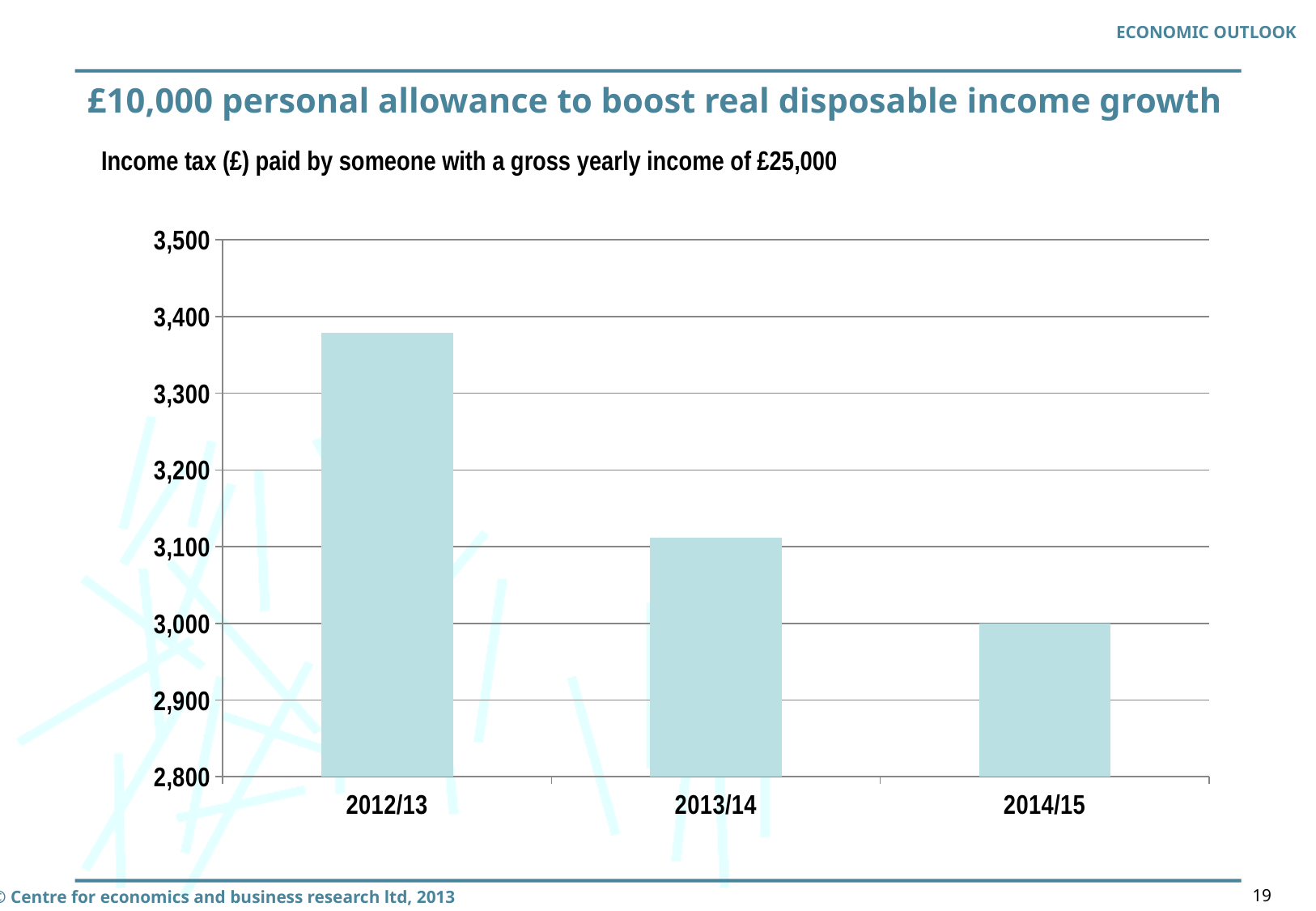
Is the income tax paid in 2013/14 greater or less than 3,100? greater Which tax year has the highest income tax paid in the chart? 2012/13 Which tax year has the lowest income tax paid in the chart? 2014/15 What is the title of the chart? Income tax (£) paid by someone with a gross yearly income of £25,000 What is the lowest value shown on the y axis of the chart? 2,800 Is the income tax paid in 2013/14 greater or less than 3,200? less Which is larger, the income tax paid in 2013/14 or in 2014/15? 2013/14 What kind of chart is shown on the slide? bar chart Do the values rise or fall from 2012/13 to 2014/15? fall Is the income tax paid in 2012/13 greater or less than 3,400? less How many tax years are shown on the x axis of the chart? 3